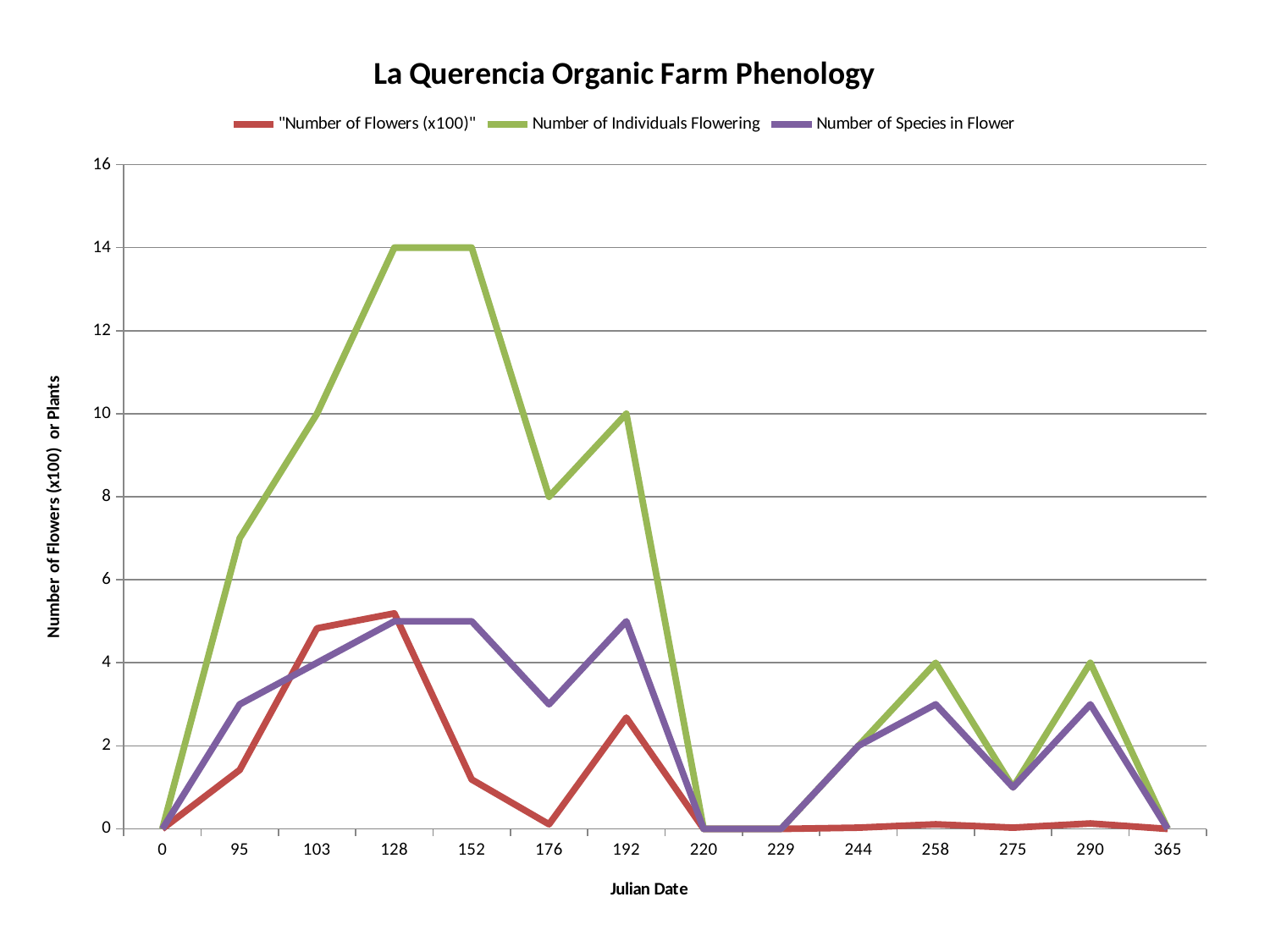
How many series does the legend list? 3 At Julian Date 192, which is larger: Number of Individuals Flowering or Number of Species in Flower? Number of Individuals Flowering What is the difference between Number of Individuals Flowering at Julian Date 128 and at Julian Date 192? 4 How many Julian Date points are shown along the x axis? 14 Is the value for Number of Species in Flower at Julian Date 95 greater or less than 2? greater What is the value of Number of Individuals Flowering at Julian Date 176? 8 What kind of chart is shown on the slide? line chart What is the title of the x axis? Julian Date Is the value for "Number of Flowers (x100)" at Julian Date 103 greater or less than 4? greater What is the value of Number of Individuals Flowering at Julian Date 128? 14 What is the value of Number of Individuals Flowering at Julian Date 192? 10 Which series reaches the highest value on the chart? Number of Individuals Flowering